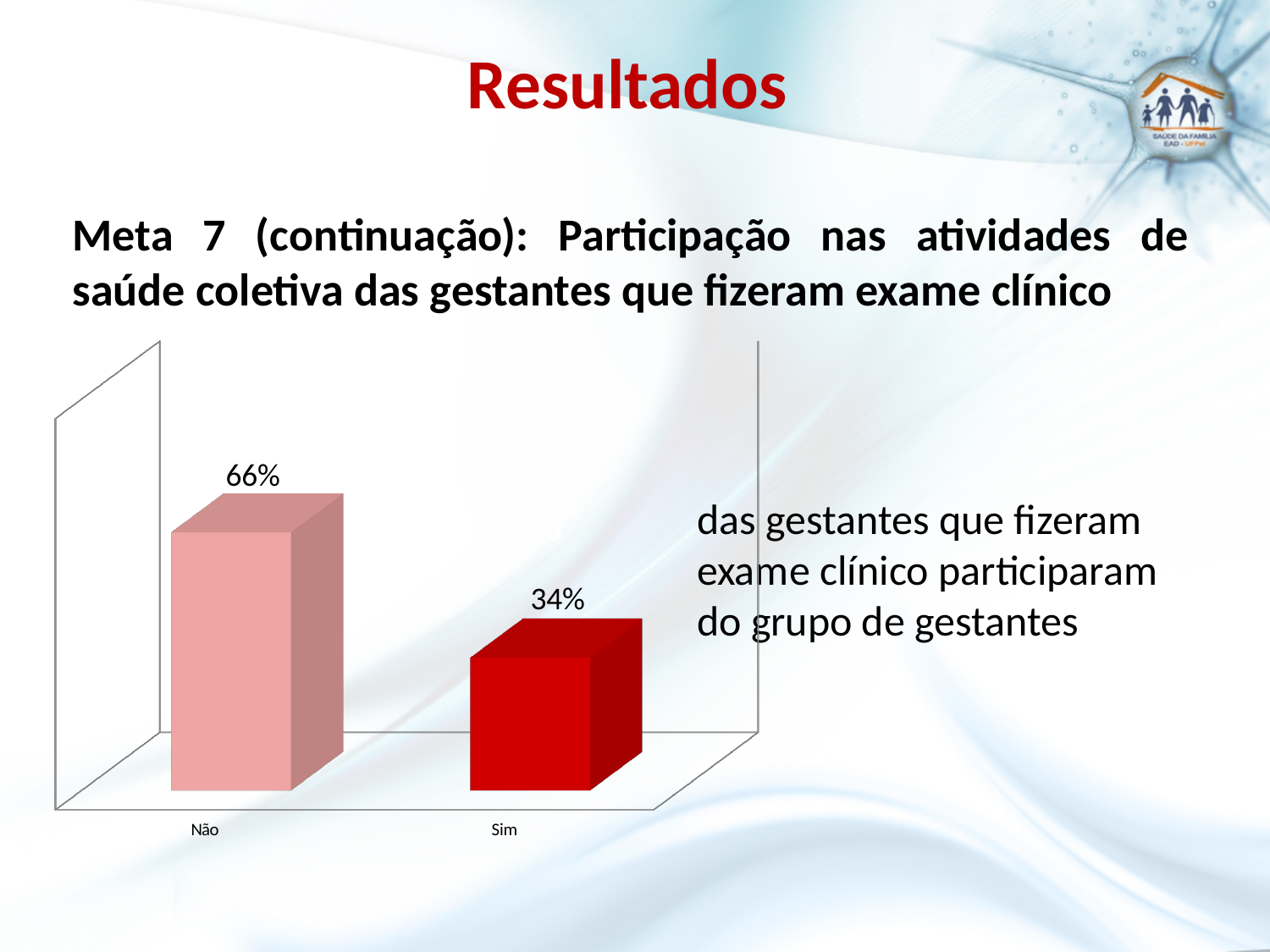
Which category has the lowest value? Sim What kind of chart is shown on the slide? Bar chart Which category has the highest value? Não Which is larger, the value for Não or the value for Sim? Não What is the difference between the values for Não and Sim? 32% What colour is the bar for Sim? Red What is the total of the two values shown in the chart? 100% Do the values rise or fall from Não to Sim? Fall What is the title of the slide? Resultados What is the value for Não? 66% What is the value for Sim? 34% How many categories are shown in the chart? 2